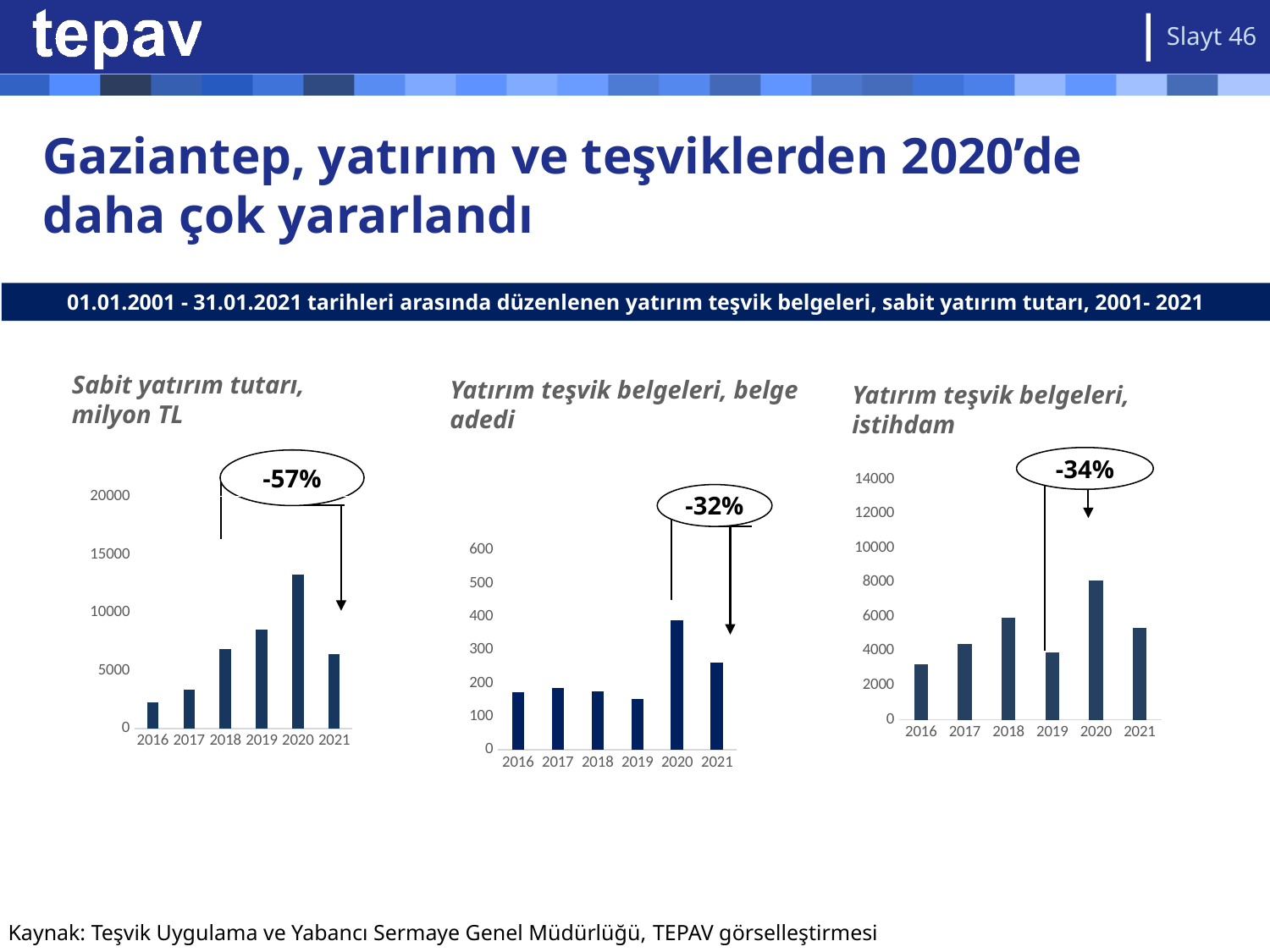
In the 'Sabit yatırım tutarı, milyon TL' chart, which year has the highest value? 2020 In the 'Yatırım teşvik belgeleri, istihdam' chart, which is larger, the value for 2018 or the value for 2019? 2018 In the 'Yatırım teşvik belgeleri, belge adedi' chart, which year has the lowest value? 2019 In the 'Yatırım teşvik belgeleri, belge adedi' chart, which year has the highest value? 2020 In the 'Yatırım teşvik belgeleri, belge adedi' chart, is the value for 2021 greater or less than 300? less In the 'Sabit yatırım tutarı, milyon TL' chart, which year has the lowest value? 2016 How many years are shown on the x axis of the 'Yatırım teşvik belgeleri, belge adedi' chart? 6 What percentage change is annotated above the 'Yatırım teşvik belgeleri, istihdam' chart? -34% In the 'Yatırım teşvik belgeleri, istihdam' chart, which year has the highest value? 2020 In the 'Yatırım teşvik belgeleri, istihdam' chart, which year has the lowest value? 2016 In the 'Sabit yatırım tutarı, milyon TL' chart, is the value for 2020 greater or less than 10000? greater What kind of chart is the 'Sabit yatırım tutarı, milyon TL' chart? bar chart